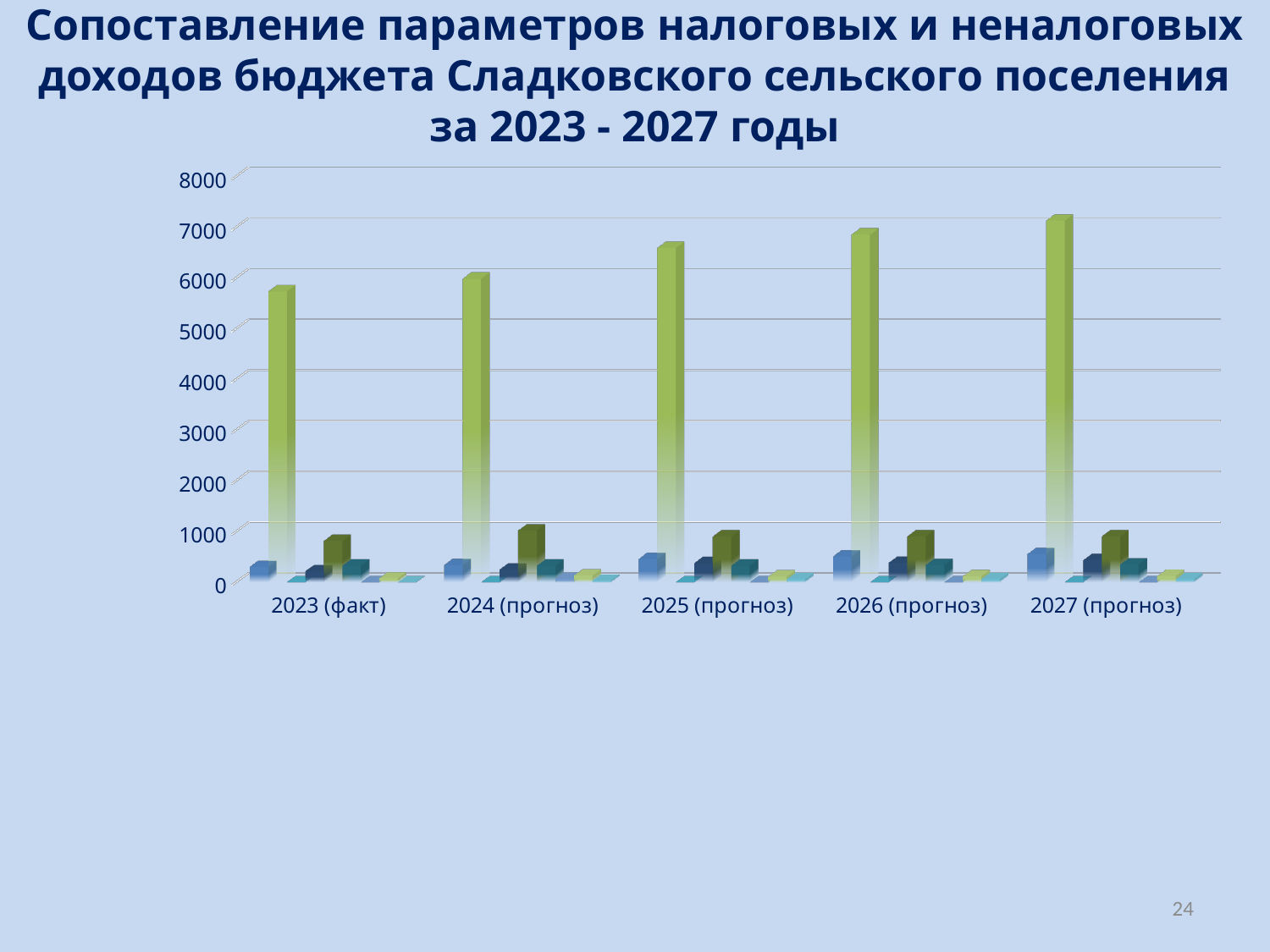
Which category has the shortest light green bar? 2023 (факт) Which category has the tallest light green bar? 2027 (прогноз) Is the light green bar for 2025 (прогноз) greater or less than 6000? greater What kind of chart is shown on the slide? bar chart Which category on the x axis is marked as actual (факт) rather than forecast? 2023 (факт) How many year categories are shown on the x axis of the chart? 5 Is the light green bar for 2023 (факт) greater or less than 6000? less Which is larger: the light green bar for 2025 (прогноз) or for 2023 (факт)? 2025 (прогноз) Is the light green bar for 2023 (факт) greater or less than 5000? greater Do the light green bars rise or fall from 2023 (факт) to 2027 (прогноз)? rise What is the highest value shown on the vertical axis of the chart? 8000